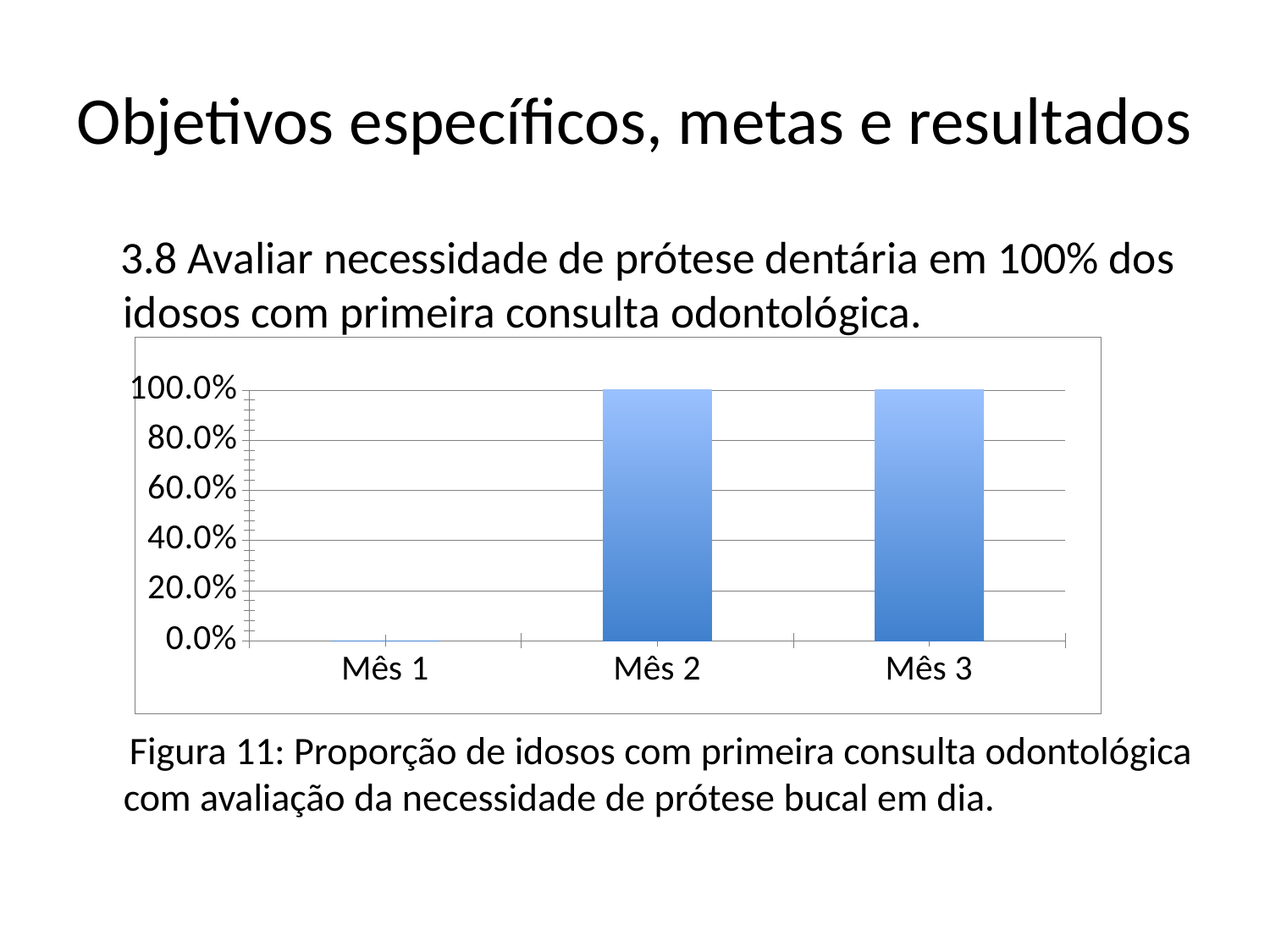
Is the value for Mês 1 greater or less than 20.0%? less What is the difference between the value for Mês 2 and the value for Mês 1? 100.0% What is the figure number given in the caption below the chart? Figura 11 How many categories are shown on the x axis of the chart? 3 What is the value for Mês 3 in the chart? 100.0% Do the values rise or fall from Mês 1 to Mês 2 along the x axis? rise Which is larger, the value for Mês 1 or the value for Mês 2? Mês 2 Which category has the lowest value in the chart? Mês 1 What is the value for Mês 1 in the chart? 0.0% What is the value for Mês 2 in the chart? 100.0% What kind of chart is shown on the slide? bar chart Is the value for Mês 3 greater or less than 80.0%? greater